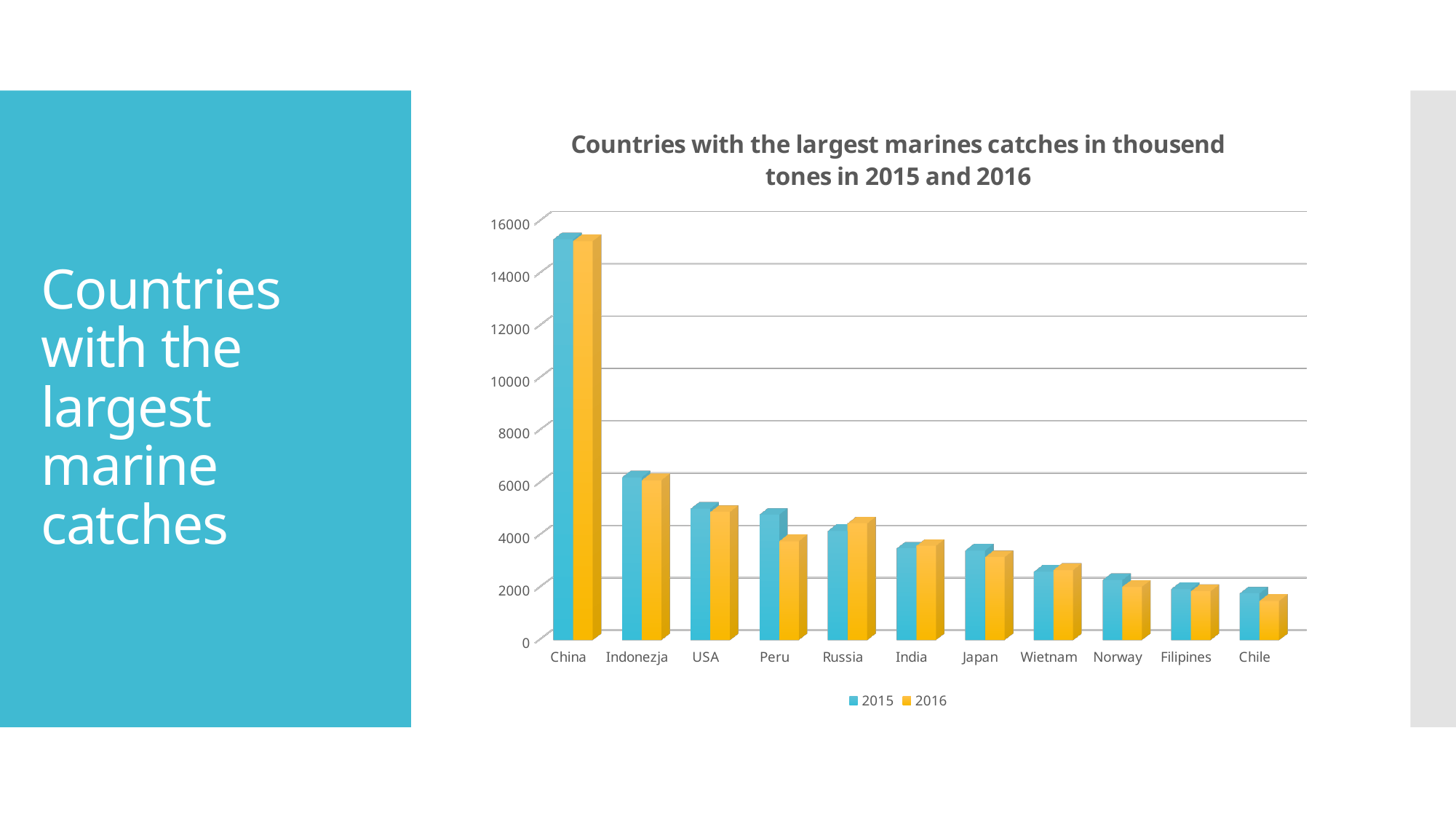
Which country has the lowest marine catch in 2016? Chile What kind of chart is shown on the slide? bar chart Do the 2015 values generally rise or fall from China on the left to Chile on the right? fall Is the value for China in 2015 greater or less than 14000? greater Is the value for Chile in 2016 greater or less than 2000? less What colour represents the 2016 series in the chart? yellow For Peru, which year has the larger value, 2015 or 2016? 2015 For Russia, which year has the larger value, 2015 or 2016? 2016 How many countries are shown on the x axis of the chart? 11 How many series does the legend list? 2 Which country has the highest marine catch in 2015? China